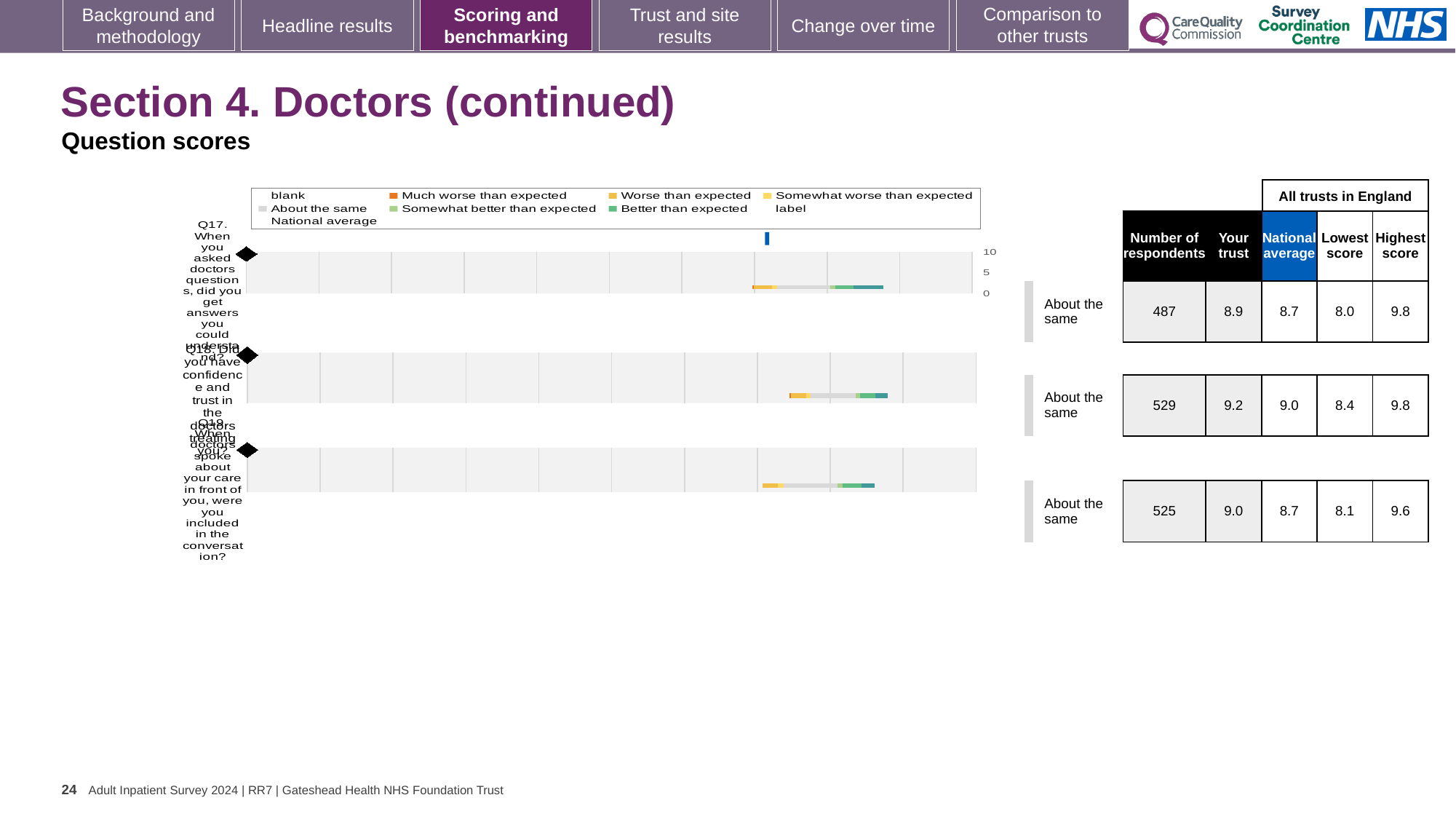
What is the 'Your trust' score for Q17 (When you asked doctors questions, did you get answers you could understand)? 8.9 What is the national average score for Q18 (Did you have confidence and trust in the doctors treating you)? 9.0 What is the difference between the 'Your trust' score and the national average for Q17? 0.2 Which question has the highest 'Your trust' score? Q18 What benchmark category is shown for Q18? About the same What kind of chart is used to show the question scores on this slide? bar chart What is the lowest score among all trusts in England for Q18? 8.4 What is the highest score among all trusts in England for Q19? 9.6 How many respondents answered Q19 (When doctors spoke about your care in front of you, were you included in the conversation)? 525 Is the 'Your trust' score for Q18 larger than the 'Your trust' score for Q19? Yes, Q18 (9.2) is larger than Q19 (9.0) How many questions (categories) are plotted in the chart? 3 Which question has the lowest number of respondents? Q17